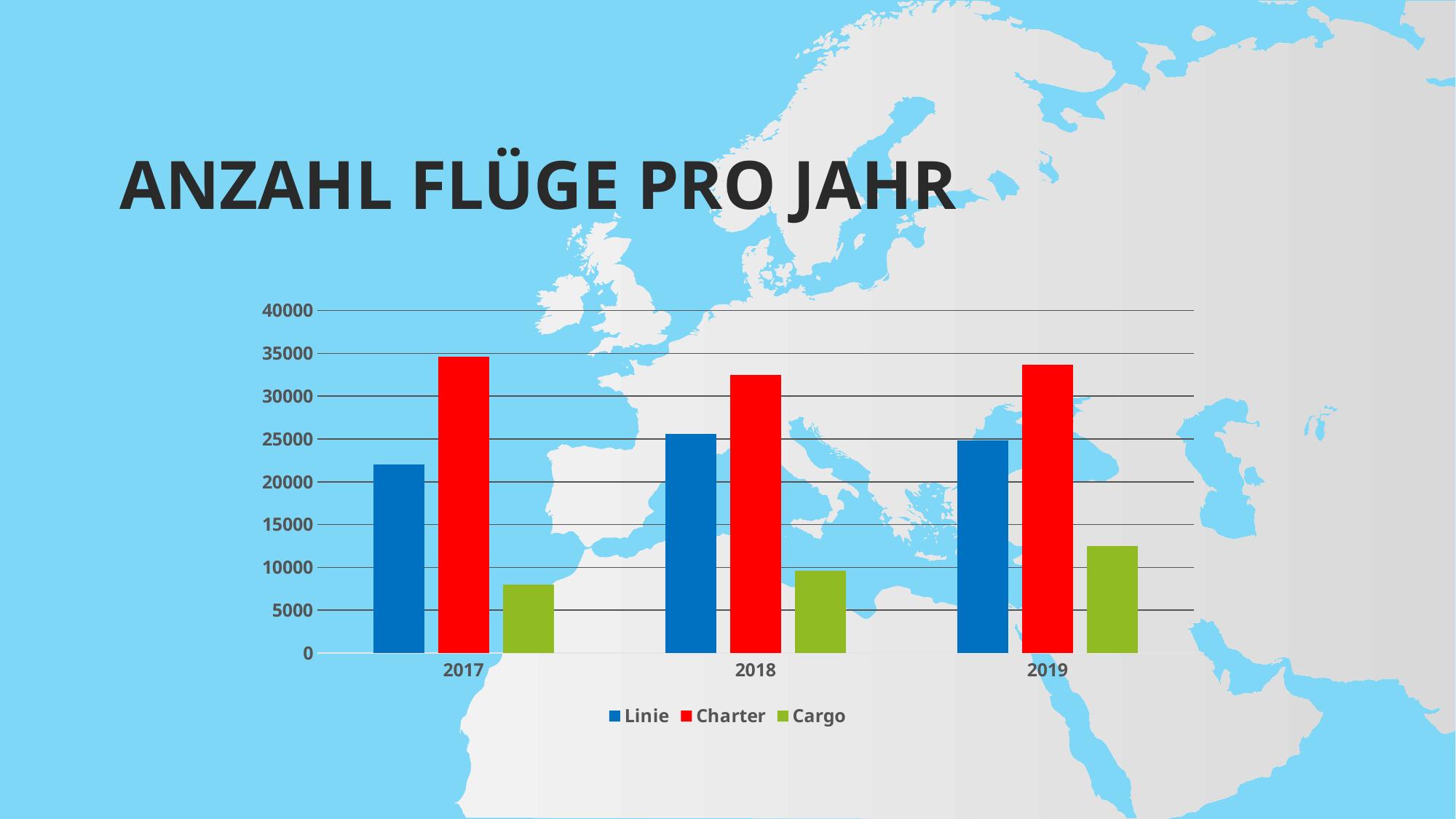
How many series does the legend list? 3 How many years are shown on the x axis? 3 Is the value for Linie in 2017 greater or less than 25000? less Which series is shown in red? Charter In which year is the Charter bar the highest? 2017 Which is larger, the Linie value in 2017 or the Linie value in 2018? 2018 In which year is the Cargo bar the lowest? 2017 What kind of chart is shown on the slide? bar chart What is the title of the chart? ANZAHL FLÜGE PRO JAHR Which series has the highest bar in every year? Charter Do the Cargo values rise or fall from 2017 to 2019? rise Is the value for Cargo in 2019 greater or less than 10000? greater